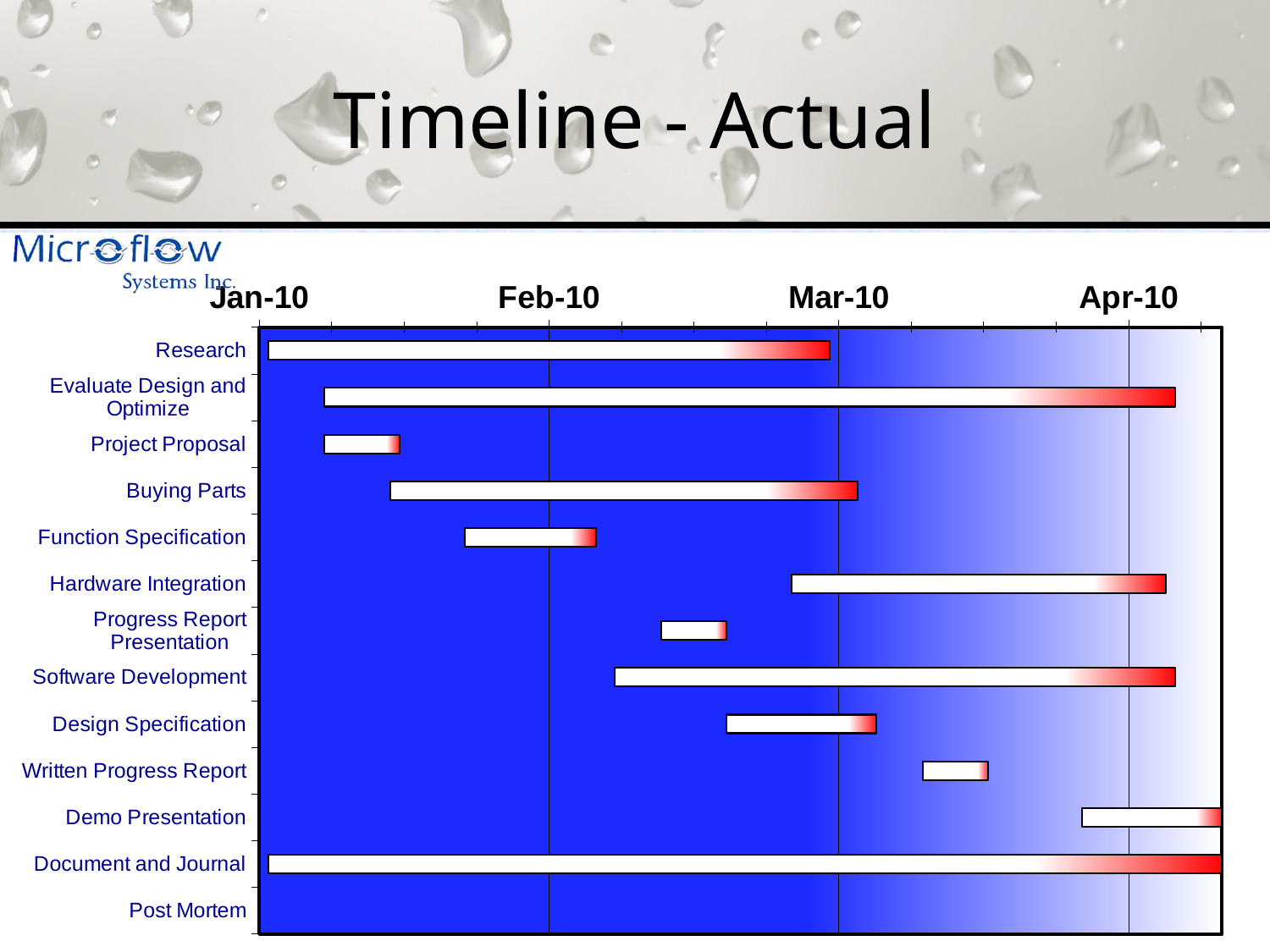
Which bar is longer, Buying Parts or Function Specification? Buying Parts Does the Evaluate Design and Optimize bar end before or after Apr-10? after What kind of chart is shown on the slide? Bar chart (Gantt chart) Which task has the longest bar in the chart? Document and Journal Does the Software Development bar start before or after Feb-10? after Which task has no bar plotted in the chart? Post Mortem What month labels are shown along the horizontal axis of the chart? Jan-10, Feb-10, Mar-10, Apr-10 What is the title of the slide containing the chart? Timeline - Actual Which bar is longer, Software Development or Design Specification? Software Development Does the Research bar end before or after Mar-10? before Which task's bar starts latest in the timeline? Demo Presentation How many tasks are listed on the vertical axis of the chart? 13